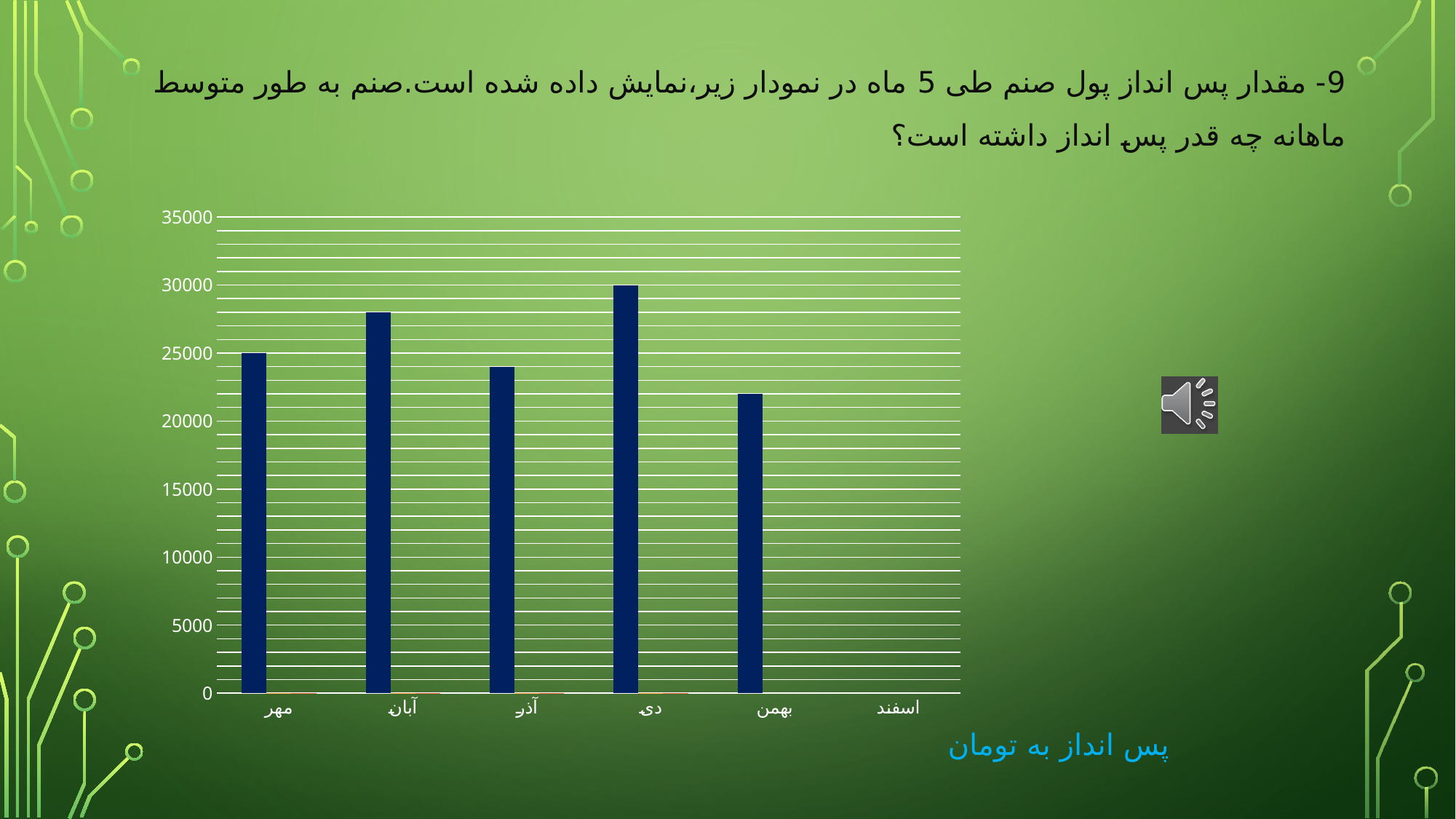
What type of chart is shown on the slide? bar chart How many bars are plotted in the chart? 5 What is the difference between the values for دی and مهر? 5000 What is the value for مهر? 25000 Is the value for بهمن greater or less than 25000? less What unit label is written below the chart? پس انداز به تومان Among the months with a plotted bar, which has the lowest value? بهمن Which is larger, the value for آبان or the value for آذر? آبان Is the value for آبان greater or less than 25000? greater Which month has the highest bar? دی What is the value for دی? 30000 Is the value for آذر greater or less than 20000? greater